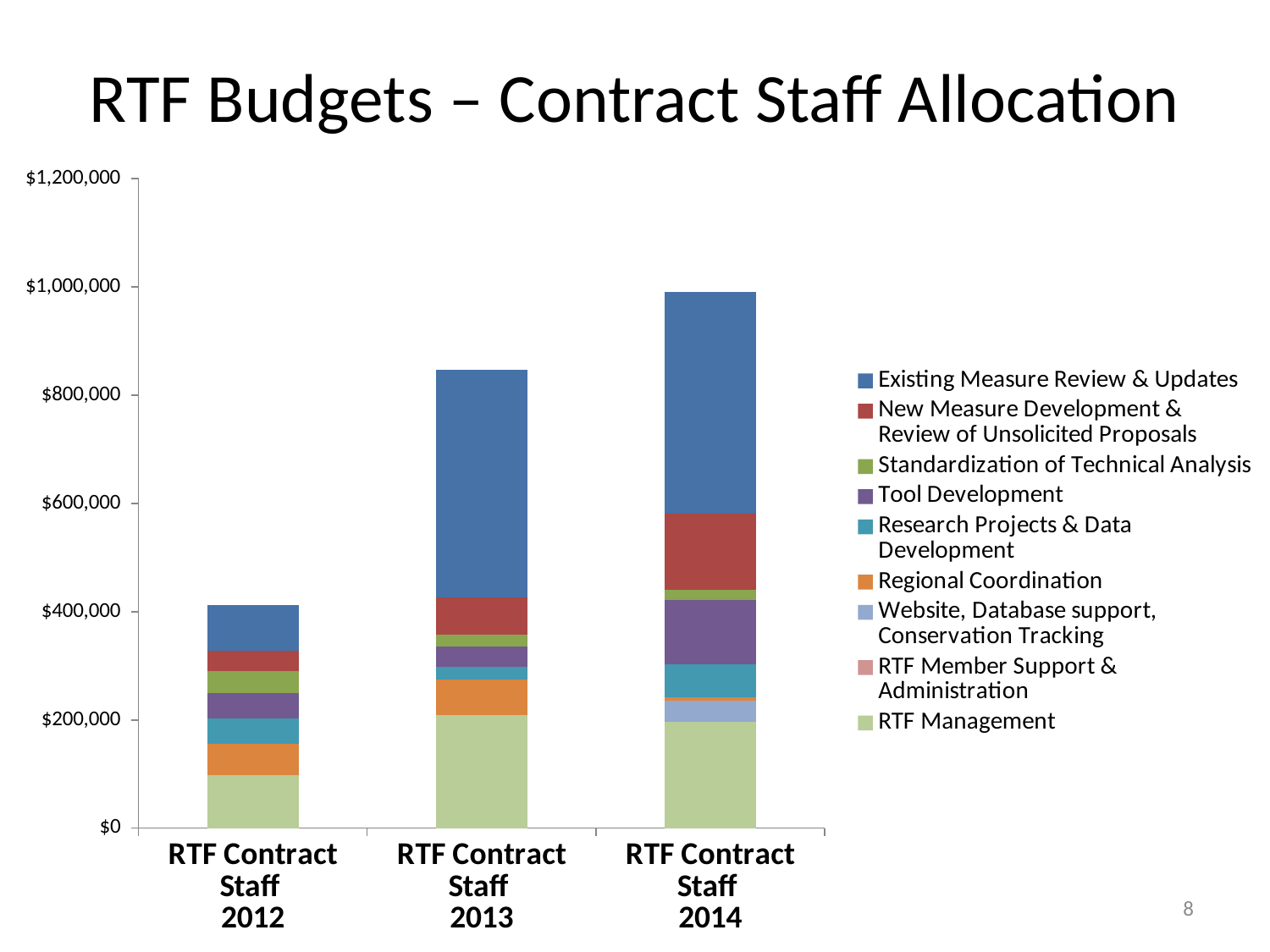
Which series is listed last in the legend? RTF Management Is the total bar for RTF Contract Staff 2013 larger or smaller than the total for RTF Contract Staff 2012? larger How many series does the legend list? 9 What kind of chart is shown on the slide? Stacked bar chart Do the total bar heights rise or fall from 2012 to 2014? rise Is the total for RTF Contract Staff 2014 greater or less than $800,000? greater Is the total for RTF Contract Staff 2013 greater or less than $600,000? greater Is the total for RTF Contract Staff 2012 greater or less than $600,000? less How many bars (categories) are plotted on the x axis? 3 What is the title of the chart on the slide? RTF Budgets – Contract Staff Allocation Which year has the shortest total bar? RTF Contract Staff 2012 Which year has the tallest total bar? RTF Contract Staff 2014